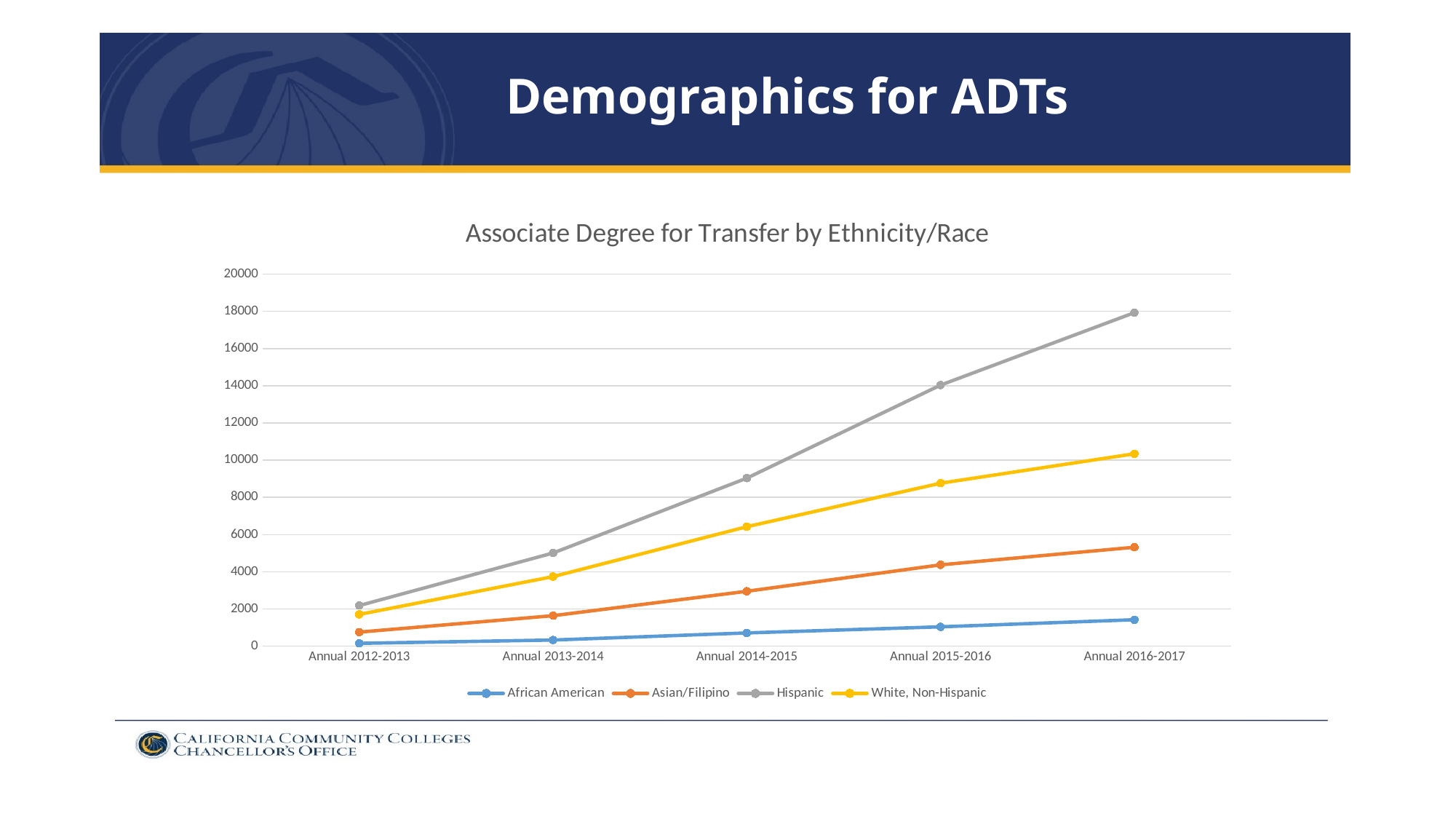
Is the value for Asian/Filipino in Annual 2016-2017 greater or less than 4000? greater Is the value for African American in Annual 2016-2017 greater or less than 2000? less Which ethnicity/race group has the lowest value in Annual 2016-2017? African American Is the value for Hispanic in Annual 2016-2017 greater or less than 16000? greater How many annual periods are shown on the x axis? 5 Which is larger in Annual 2015-2016, the value for White, Non-Hispanic or the value for Asian/Filipino? White, Non-Hispanic Which ethnicity/race group has the highest value in Annual 2016-2017? Hispanic What kind of chart is shown on the slide? line chart What is the title of the chart? Associate Degree for Transfer by Ethnicity/Race How many series does the legend list? 4 Do the values for Hispanic rise or fall from Annual 2012-2013 to Annual 2016-2017? rise